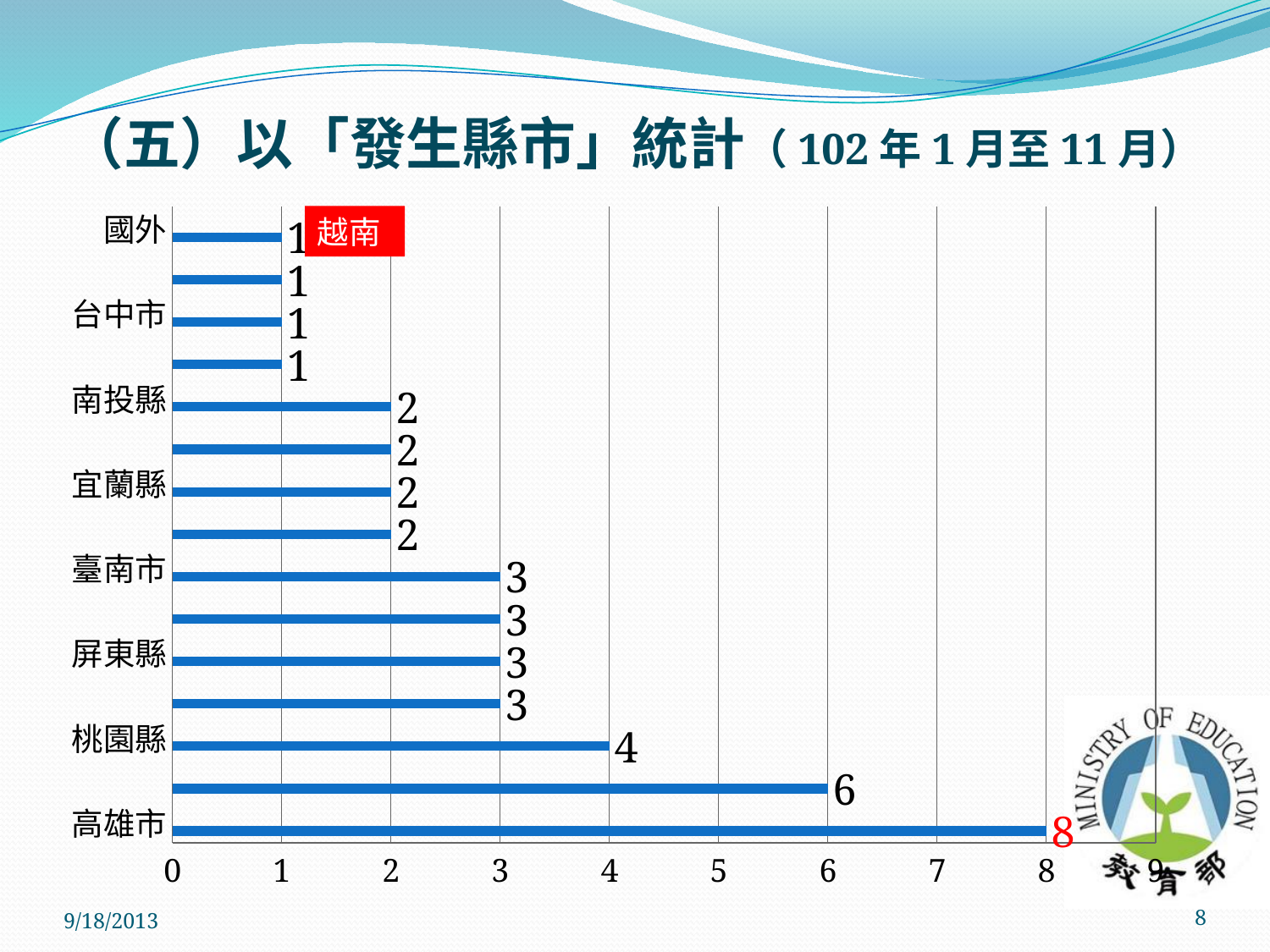
Which is larger, the value for 屏東縣 or the value for 宜蘭縣? 屏東縣 What is the value for 高雄市? 8 Is the value for 高雄市 greater or less than 6? greater What is the value for 南投縣? 2 What kind of chart is shown on the slide? bar chart How many bars are plotted in the chart? 15 What is the difference between the values for 高雄市 and 桃園縣? 4 What is the value for 桃園縣? 4 What is the value for 臺南市? 3 Which category has the highest value? 高雄市 What text is shown in the red annotation box next to the 國外 bar? 越南 What is the value for 國外? 1